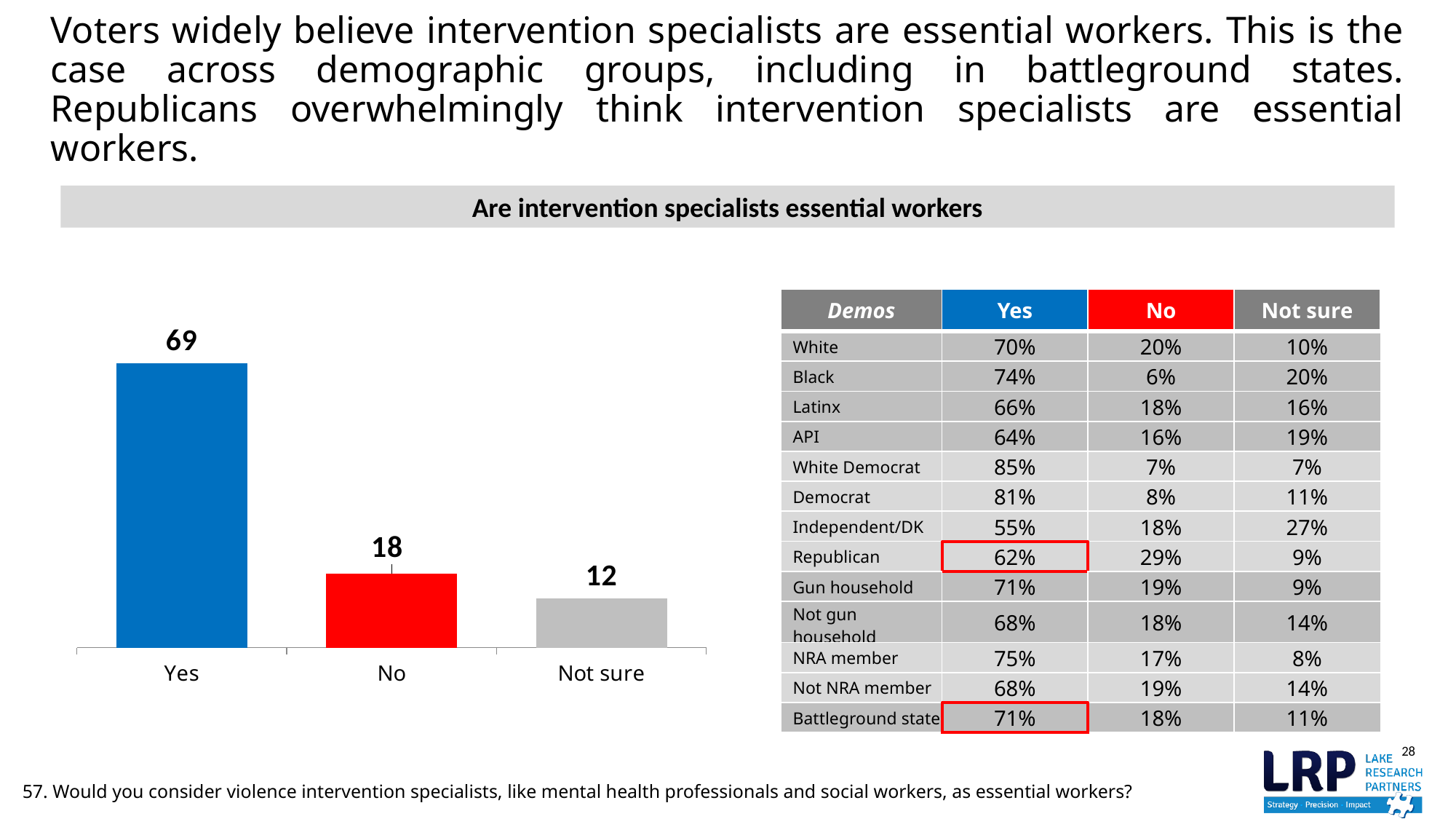
Do the bar values rise or fall from left to right across the chart? Fall How many categories are shown in the bar chart? 3 What kind of chart is shown on the slide? Bar chart Which is larger, the No bar or the Not sure bar? No What is the title shown above the chart? Are intervention specialists essential workers What is the value of the Not sure bar in the chart? 12 Which category has the lowest bar in the chart? Not sure Which category has the highest bar in the chart? Yes What is the value of the No bar in the chart? 18 What is the difference between the Yes bar and the No bar? 51 What is the value of the Yes bar in the chart? 69 What is the difference between the No bar and the Not sure bar? 6